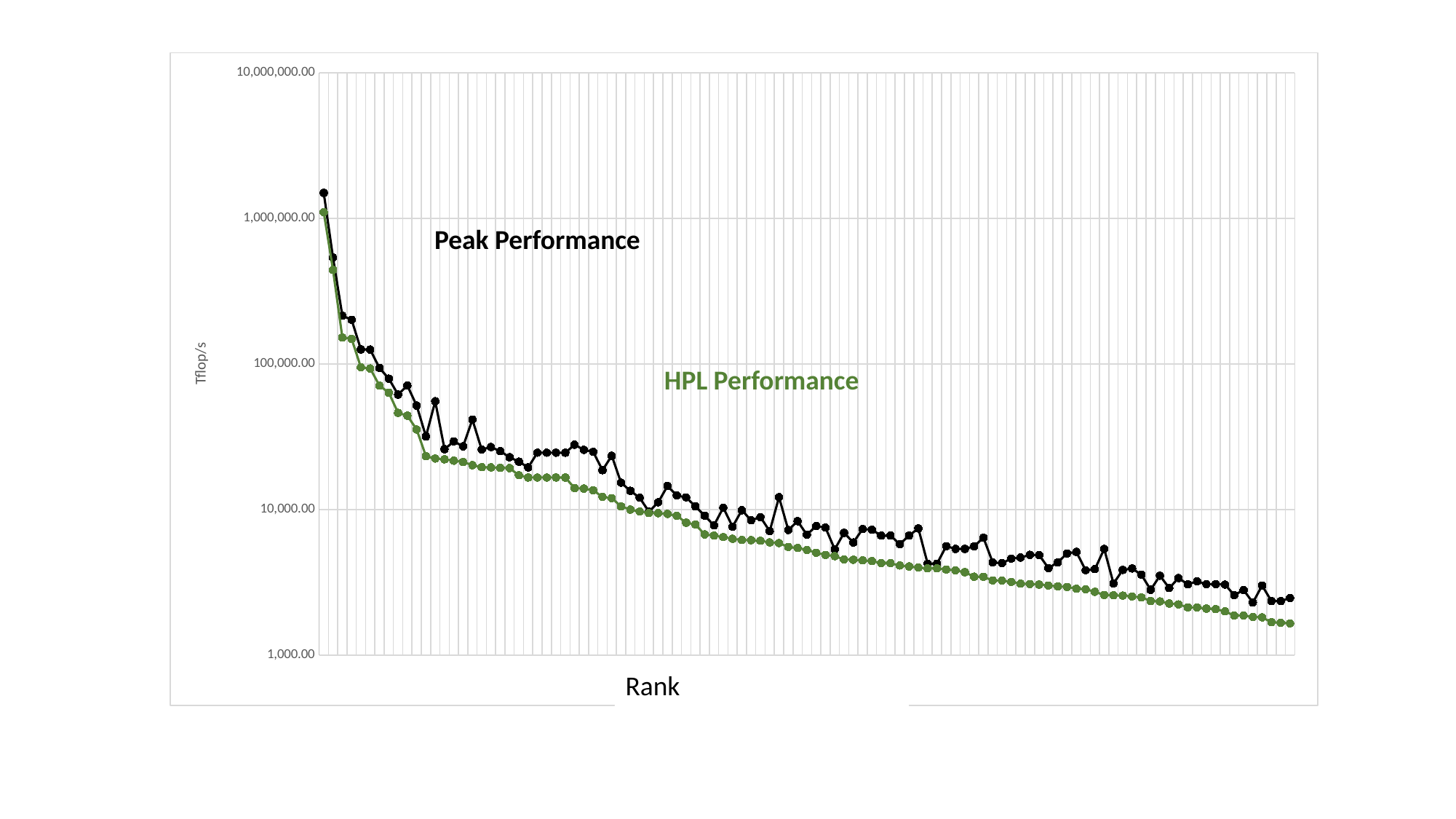
What is the label of the x axis? Rank Is the last (rightmost) HPL Performance value greater or less than 1,000.00? greater Do the values of the HPL Performance series rise or fall along the x axis? Fall Is the last (rightmost) HPL Performance value greater or less than 10,000.00? less At the rightmost rank, which series has the larger value, Peak Performance or HPL Performance? Peak Performance Do the values of the Peak Performance series rise or fall as rank increases along the x axis? Fall What kind of chart is shown on the slide? Line chart What are the names of the two series plotted on the chart? Peak Performance and HPL Performance Which series is drawn in green? HPL Performance Is the last (rightmost) Peak Performance value greater or less than 1,000.00? greater How many data series are plotted on the chart? 2